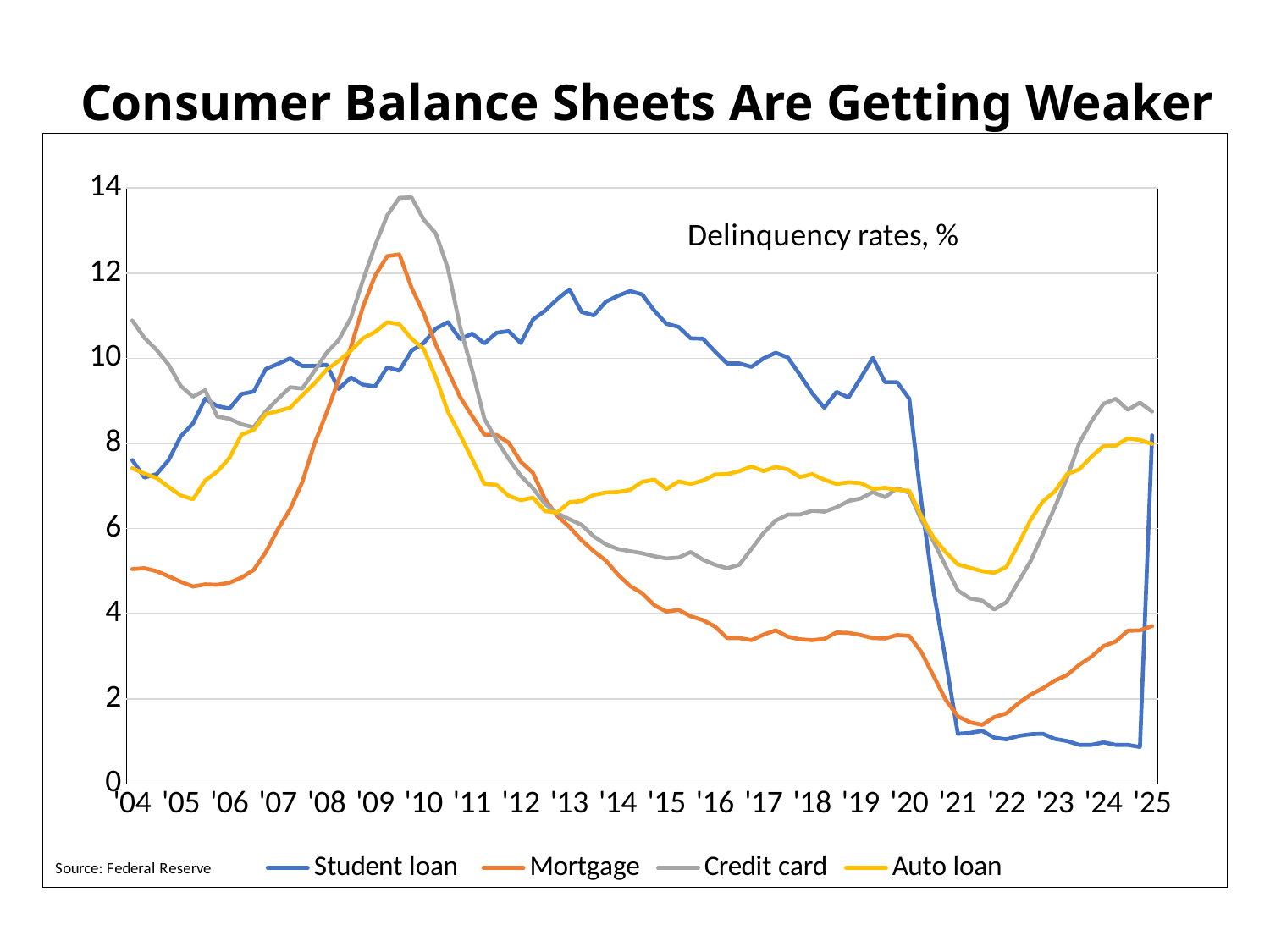
In '09, which series has the higher delinquency rate, Credit card or Mortgage? Credit card Which series has the lowest delinquency rate in '23? Student loan How many series does the legend list? 4 Is the Student loan delinquency rate in '23 greater or less than 2? less Is the Student loan delinquency rate in '14 greater or less than 10? greater What is the title of the slide? Consumer Balance Sheets Are Getting Weaker What source is cited for the chart? Federal Reserve Is the Mortgage delinquency rate in '22 greater or less than 2? less In '16, which series has the higher delinquency rate, Auto loan or Mortgage? Auto loan Which series reaches the highest delinquency rate anywhere on the chart? Credit card What kind of chart is shown on the slide? line chart